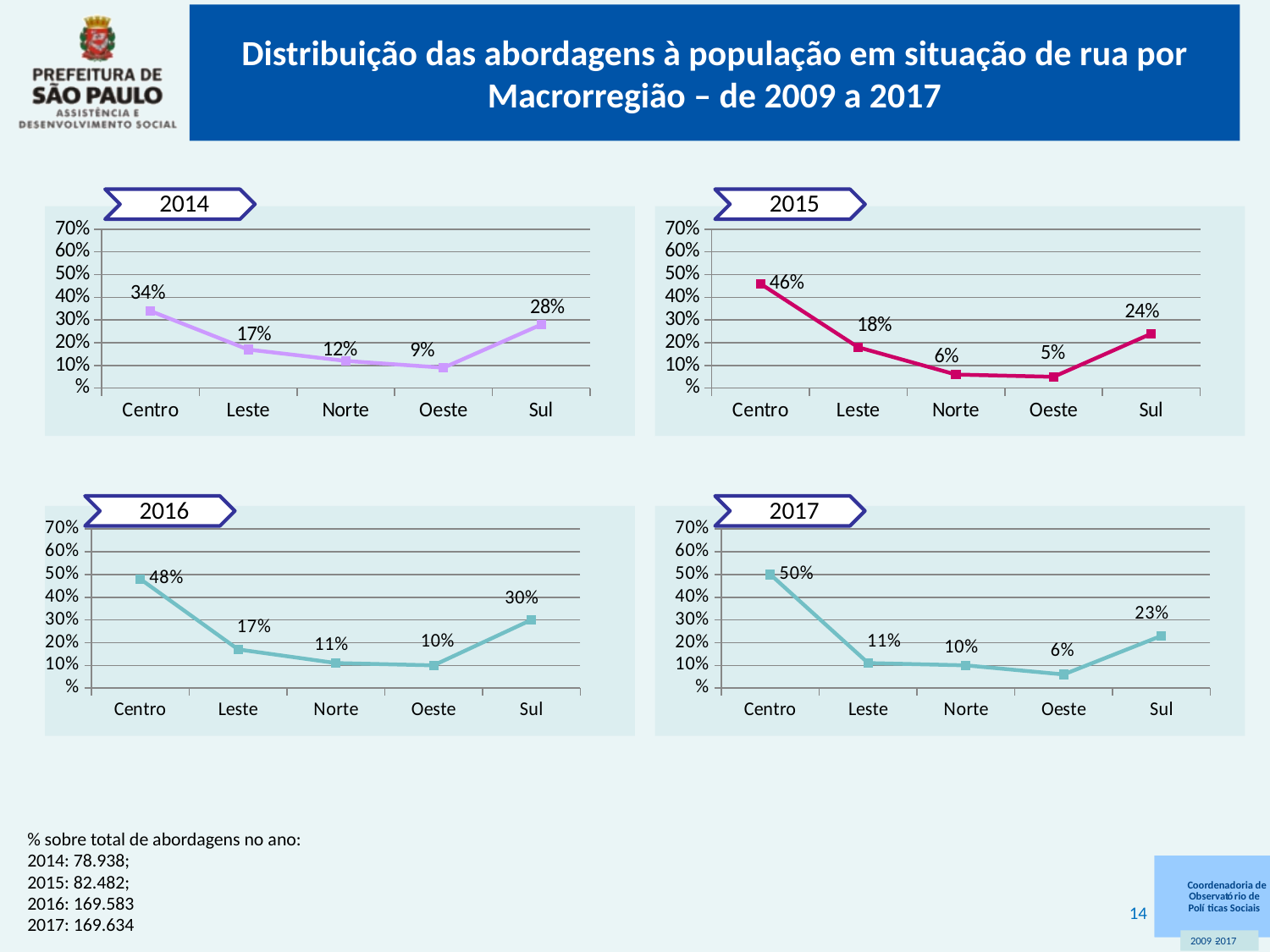
How many regions are shown on the x axis of the 2015 chart? 5 In the 2015 chart, what is the difference between the values for Centro and Sul? 22% How many charts are shown on the slide? 4 In the 2017 chart, which region has the highest value? Centro In the 2014 chart, which region has the lowest value? Oeste In the 2015 chart, what is the value for Oeste? 5% In the 2016 chart, is the value for Centro greater or less than 40%? greater In the 2014 chart, what is the value for Centro? 34% In the 2017 chart, do the values rise or fall from Centro to Oeste? fall In the 2017 chart, which is larger, the value for Leste or the value for Sul? Sul In the 2016 chart, what is the value for Sul? 30% What kind of chart is the 2014 chart? line chart